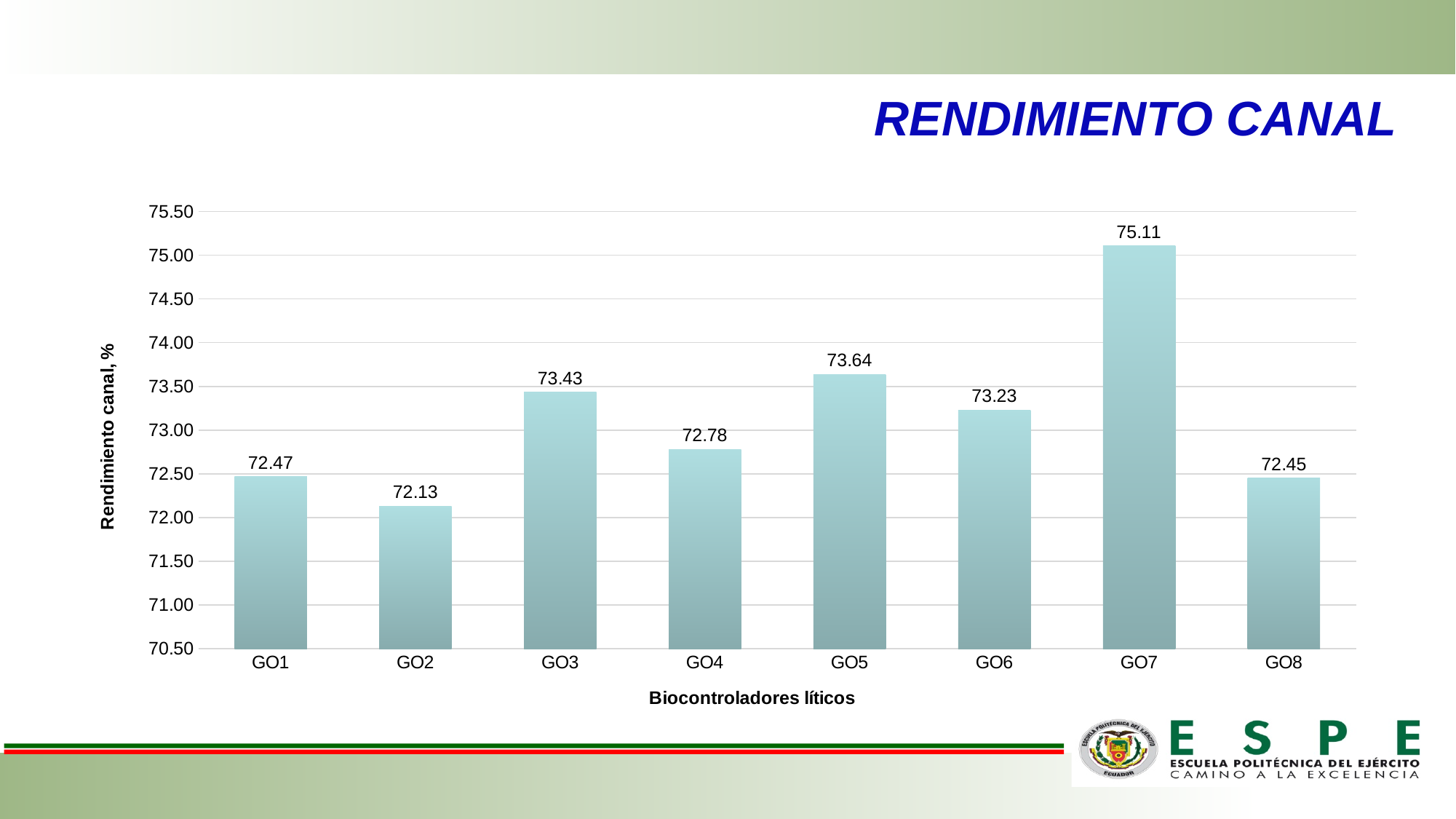
Is the value for GO3 greater or less than 73.00? greater What is the value for GO5? 73.64 What is the difference between the values for GO3 and GO4? 0.65 What is the value for GO2? 72.13 What is the value for GO7? 75.11 Which is larger, the value for GO5 or the value for GO6? GO5 What is the label of the x axis? Biocontroladores líticos Which category has the highest value? GO7 What is the difference between the values for GO7 and GO2? 2.98 How many categories are shown on the x axis? 8 What kind of chart is shown on the slide? bar chart Which category has the lowest value? GO2